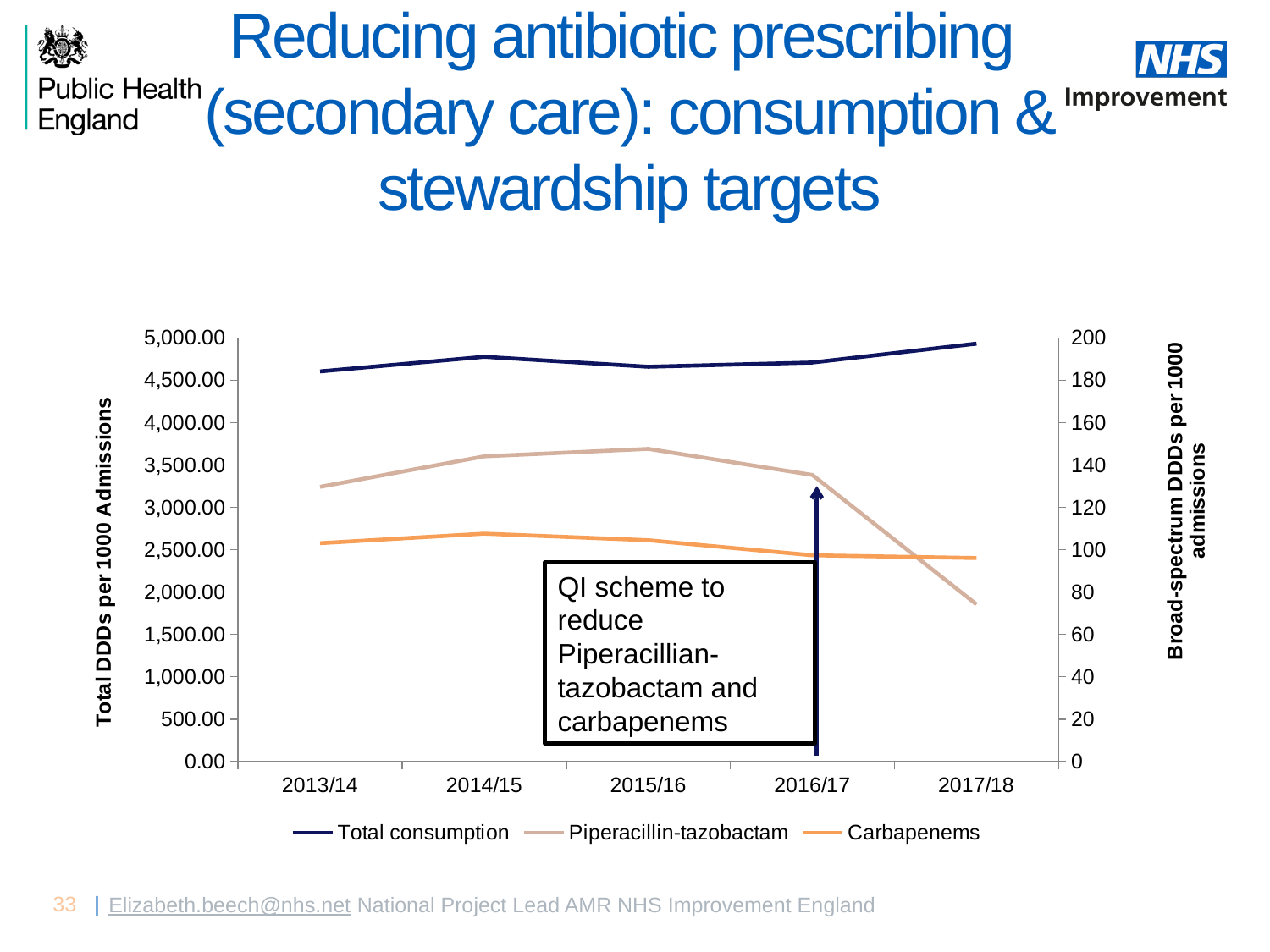
Does Piperacillin-tazobactam rise or fall from 2015/16 to 2017/18? fall How many time periods are plotted along the x axis? 5 In which year is Piperacillin-tazobactam lowest? 2017/18 In which year is Piperacillin-tazobactam highest? 2015/16 In 2017/18, which is higher: Piperacillin-tazobactam or Carbapenems? Carbapenems What kind of chart is shown on the slide? line chart Is the Piperacillin-tazobactam value for 2017/18 greater or less than 100 on the right-hand axis? less Is the Total consumption value for 2017/18 greater or less than 5,000.00 on the left axis? less In 2013/14, which is higher: Piperacillin-tazobactam or Carbapenems? Piperacillin-tazobactam In which year is Total consumption highest? 2017/18 What does the text box annotation on the chart say? QI scheme to reduce Piperacillian-tazobactam and carbapenems How many series does the legend list? 3